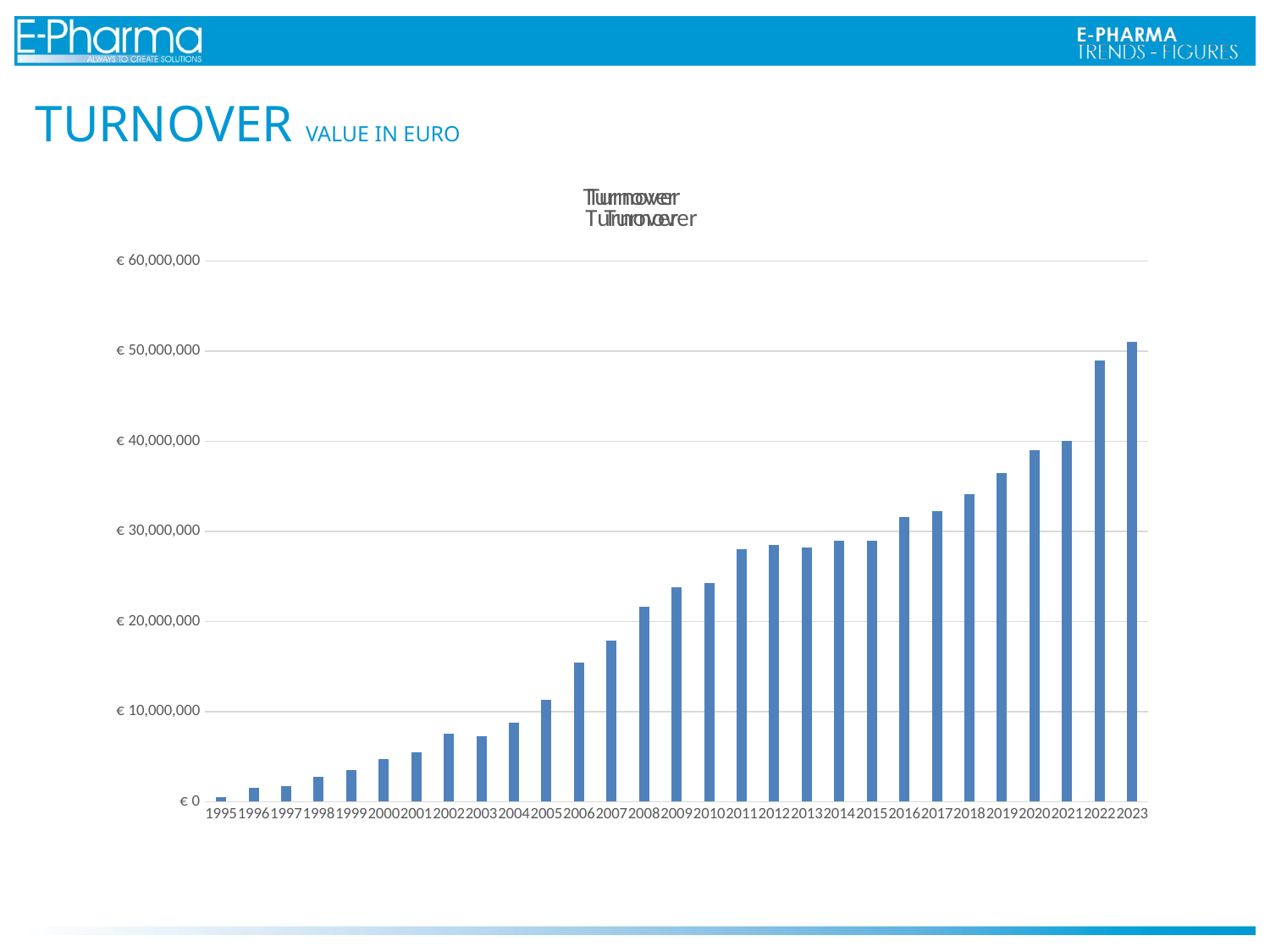
How many years (bars) are plotted in the Turnover chart? 29 Is the turnover for 2005 greater or less than € 10,000,000? greater What is the highest value shown on the vertical axis of the chart? € 60,000,000 Do turnover values generally rise or fall from 1995 to 2023? rise Which year has the larger turnover, 2010 or 2005? 2010 Which year has the lowest turnover? 1995 Is the turnover for 2019 greater or less than € 40,000,000? less Is the turnover for 2023 greater or less than € 50,000,000? greater Which year has the highest turnover? 2023 What kind of chart is shown on the slide? bar chart